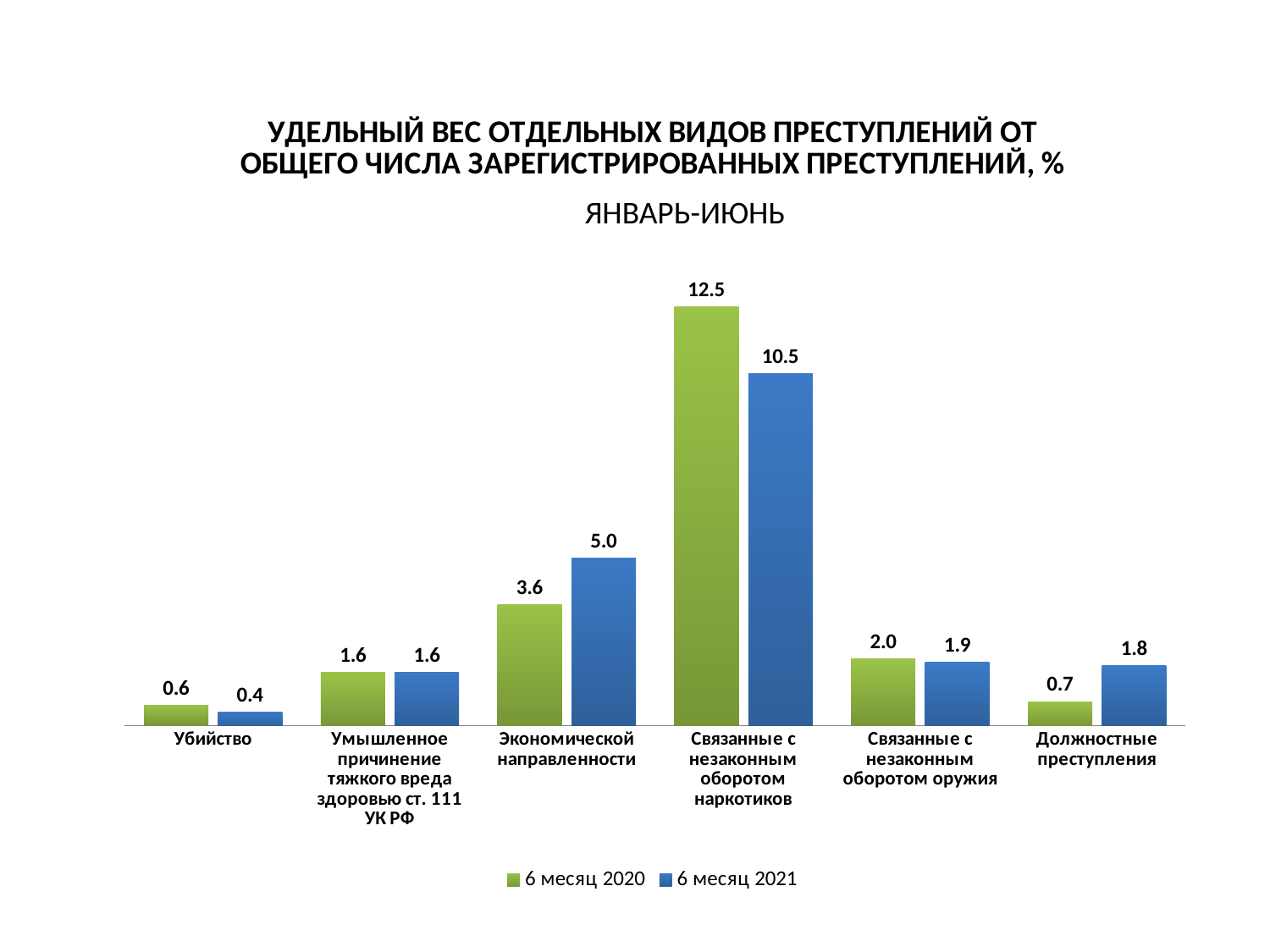
What kind of chart is shown on the slide? bar chart Which category has the highest value in the 6 месяц 2020 series? Связанные с незаконным оборотом наркотиков What is the value for Связанные с незаконным оборотом наркотиков in the 6 месяц 2021 series? 10.5 What is the difference between the 6 месяц 2020 and 6 месяц 2021 values for Связанные с незаконным оборотом наркотиков? 2.0 Which is larger for Должностные преступления: the 6 месяц 2020 value or the 6 месяц 2021 value? 6 месяц 2021 How many series does the legend list? 2 What is the difference between the 6 месяц 2021 and 6 месяц 2020 values for Экономической направленности? 1.4 What is the value for Экономической направленности in the 6 месяц 2021 series? 5.0 How many categories are shown on the x axis? 6 What is the value for Убийство in the 6 месяц 2020 series? 0.6 Which colour represents the 6 месяц 2021 series? blue Which category has the lowest value in the 6 месяц 2021 series? Убийство